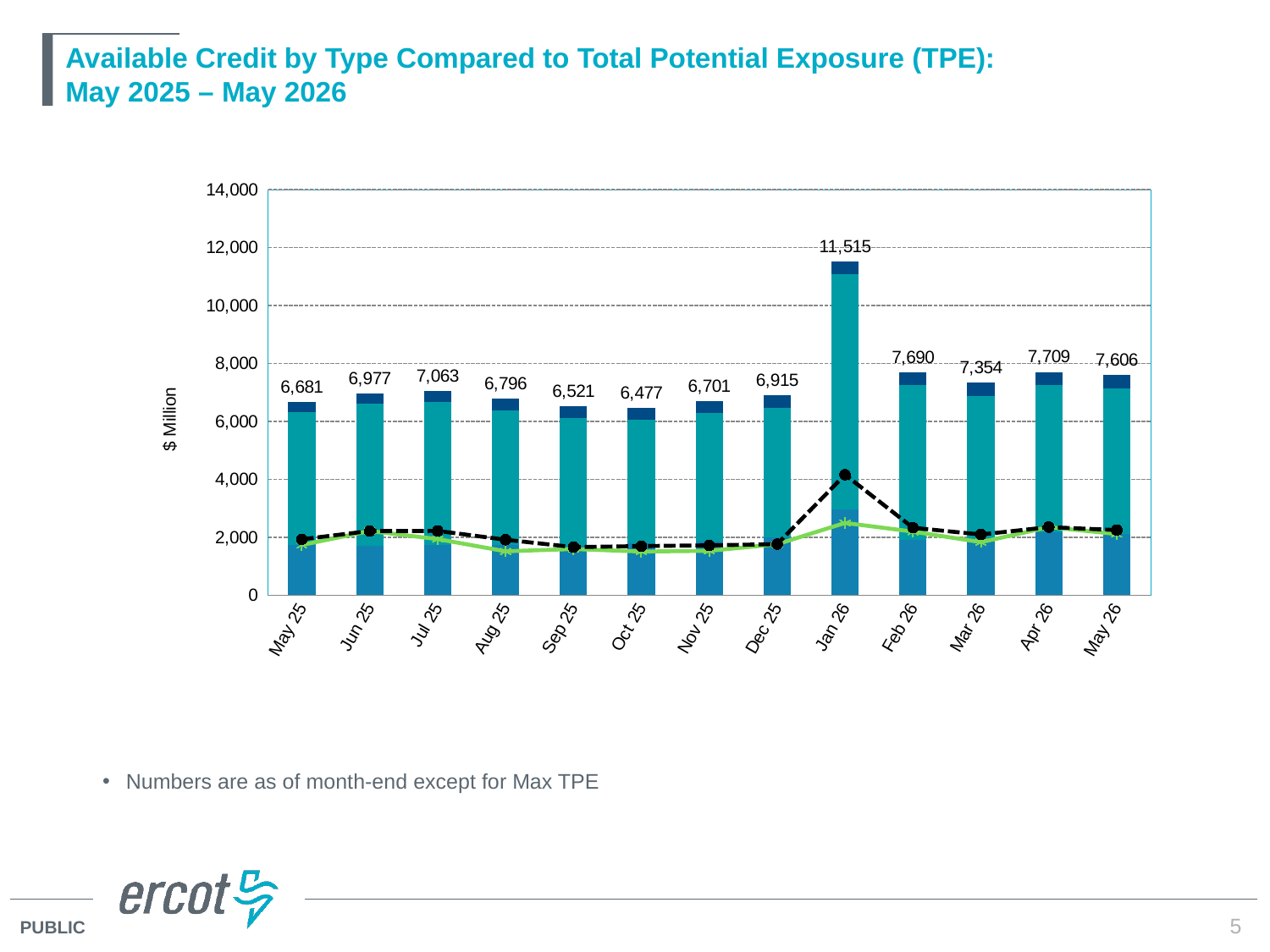
What is the total bar value for Oct 25? 6,477 Is the value of the dashed black line for Jan 26 greater or less than 2,000? greater How many months are shown on the x axis? 13 What kind of chart is shown on the slide? Stacked bar chart with line series Which month has the highest total bar value? Jan 26 Which month has the lowest total bar value? Oct 25 What is the difference between the total bar values for Jan 26 and Feb 26? 3,825 What is the label on the y axis? $ Million What is the total bar value for Apr 26? 7,709 What is the total bar value for Jan 26? 11,515 What is the difference between the total bar values for Apr 26 and Mar 26? 355 Which has a larger total bar value, Jun 25 or Aug 25? Jun 25